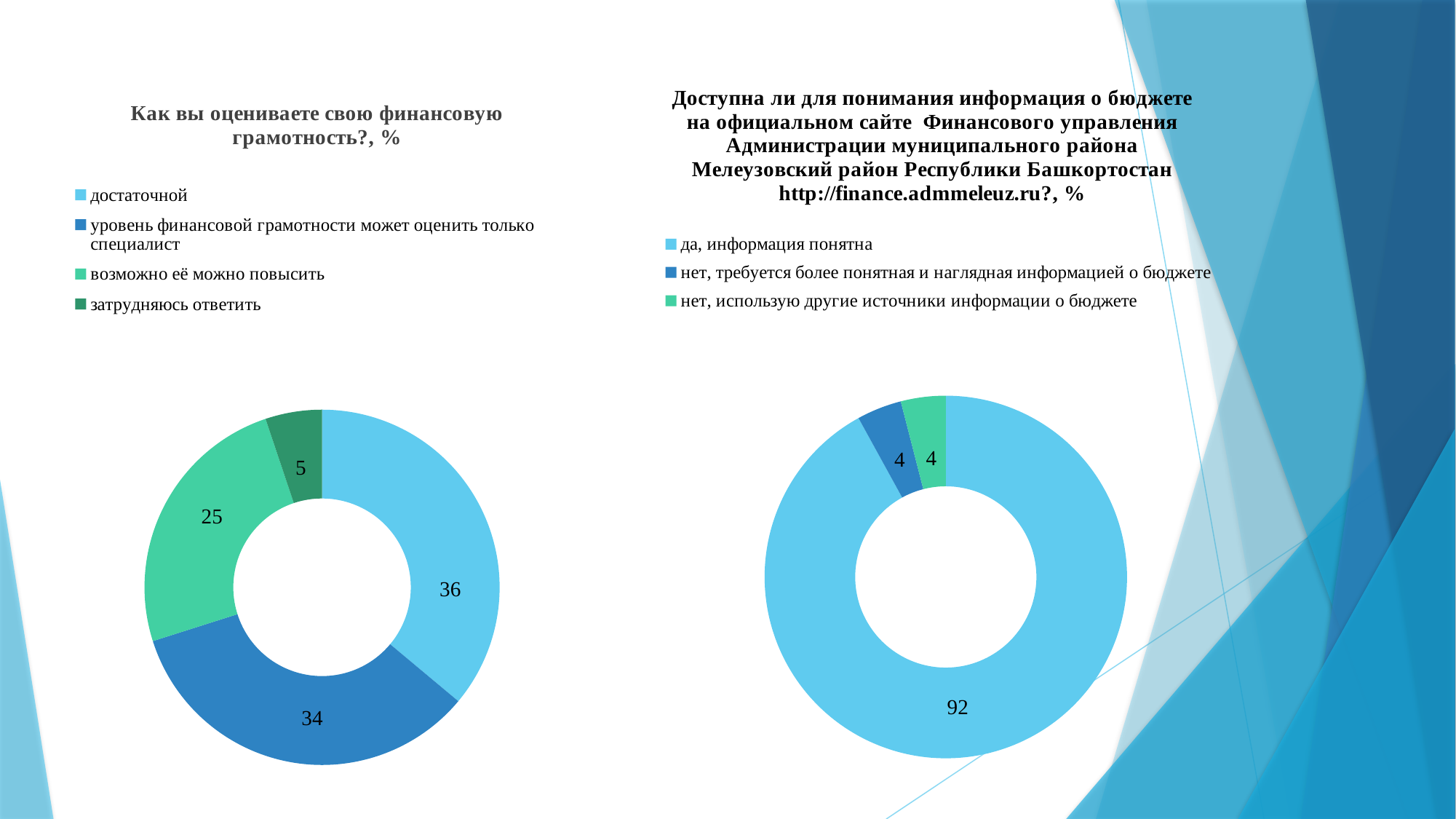
What type of chart is the left chart? Doughnut chart On the left chart, what is the value for "затрудняюсь ответить"? 5 On the left chart, which is larger: the value for "достаточной" or the value for "возможно её можно повысить"? достаточной On the left chart, what is the value for "достаточной"? 36 On the right chart, what is the value for "нет, использую другие источники информации о бюджете"? 4 On the left chart, which category has the smallest slice? затрудняюсь ответить On the left chart, what is the difference between the values for "возможно её можно повысить" and "затрудняюсь ответить"? 20 On the right chart, how many categories does the legend list? 3 On the left chart, how many categories are shown? 4 On the right chart, which category has the largest slice? да, информация понятна On the left chart, which category has the largest slice? достаточной On the right chart, what is the value for "да, информация понятна"? 92